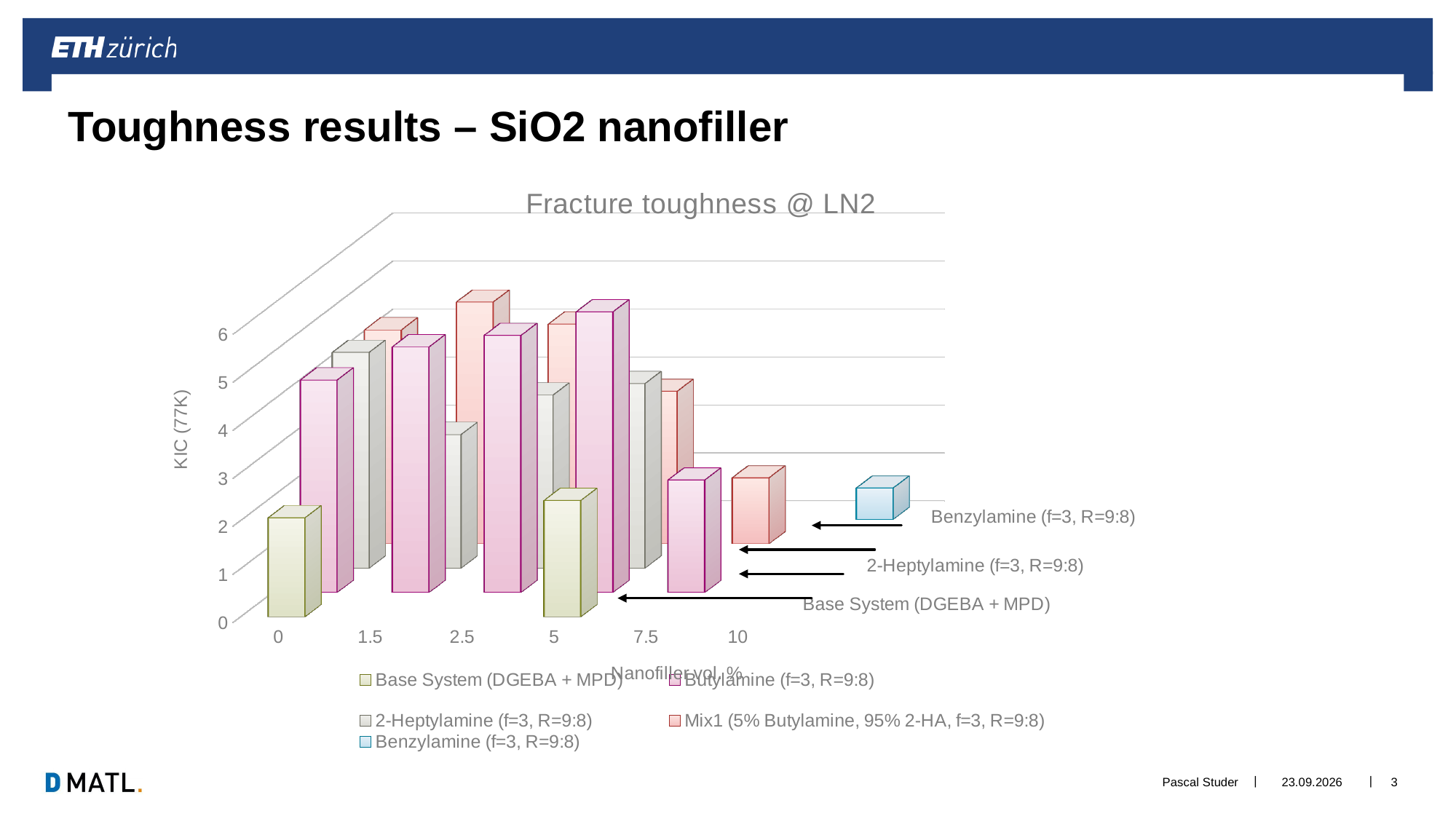
What kind of chart is shown on the slide? bar chart What is the title of the chart? Fracture toughness @ LN2 Which is larger, the Mix1 (5% Butylamine, 95% 2-HA, f=3, R=9:8) value at 2.5 vol. % or at 7.5 vol. %? 2.5 vol. % How many nanofiller vol. % categories are shown on the x axis? 6 Which is larger, the 2-Heptylamine (f=3, R=9:8) value at 1.5 vol. % or at 2.5 vol. %? 2.5 vol. % Which is larger, the Base System (DGEBA + MPD) value at 0 vol. % or the Butylamine (f=3, R=9:8) value at 1.5 vol. %? Butylamine (f=3, R=9:8) at 1.5 vol. % At which nanofiller vol. % is the Mix1 (5% Butylamine, 95% 2-HA, f=3, R=9:8) value highest? 1.5 What is the label of the vertical axis? KIC (77K) At which nanofiller vol. % is the Butylamine (f=3, R=9:8) value lowest? 7.5 How many series does the chart legend list? 5